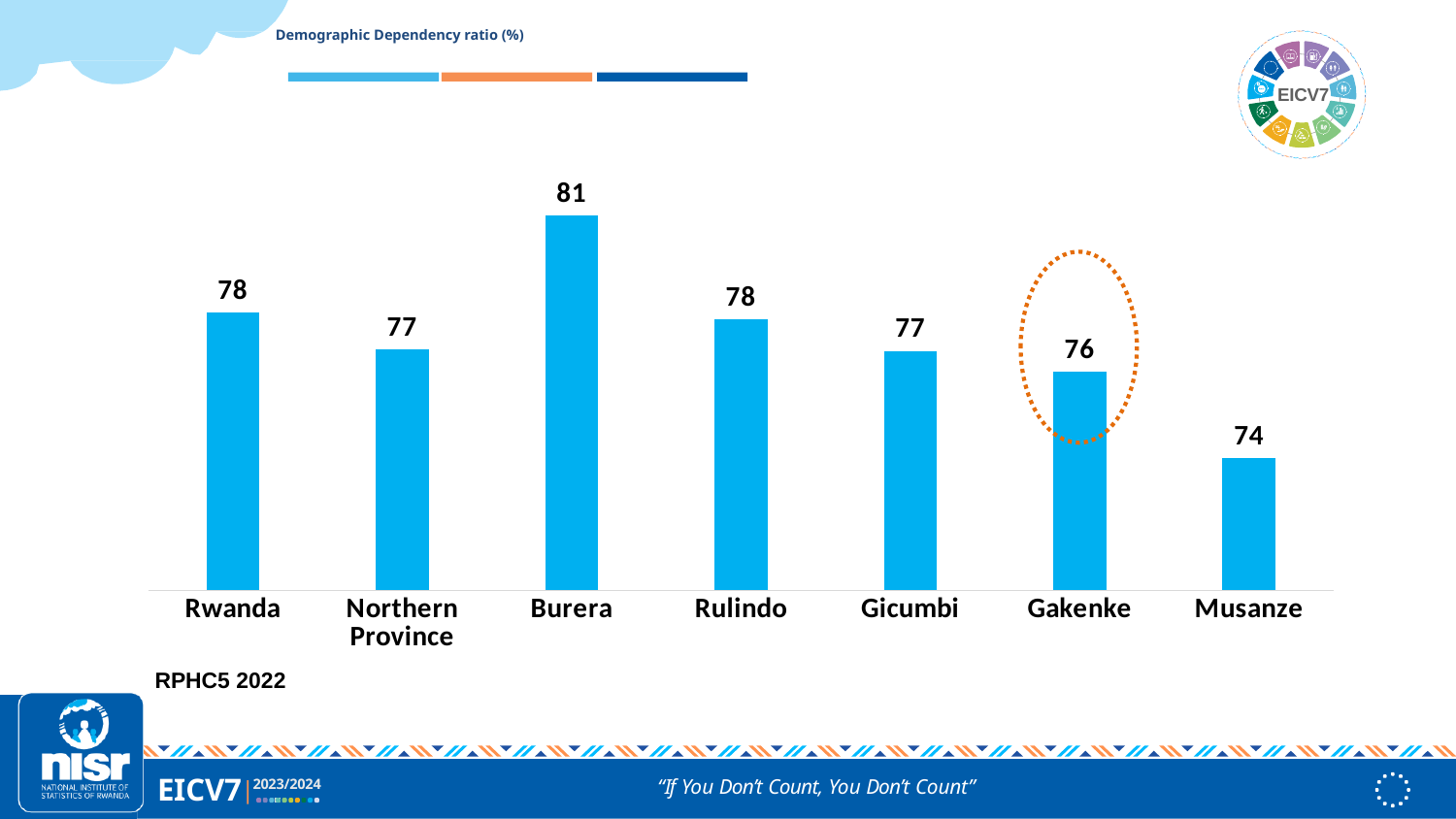
Which category has the lowest demographic dependency ratio? Musanze Which category is highlighted with a dotted orange circle? Gakenke What is the difference between the demographic dependency ratio of Rwanda and Gicumbi? 1 What is the demographic dependency ratio for Gakenke? 76 Which category has the highest demographic dependency ratio? Burera What is the demographic dependency ratio for Musanze? 74 How many categories are shown in the chart? 7 Which has a higher demographic dependency ratio, Rulindo or Gakenke? Rulindo What type of chart is shown on the slide? Bar chart What is the demographic dependency ratio for Burera? 81 What is the difference between the demographic dependency ratio of Burera and Musanze? 7 What is the demographic dependency ratio for Northern Province? 77